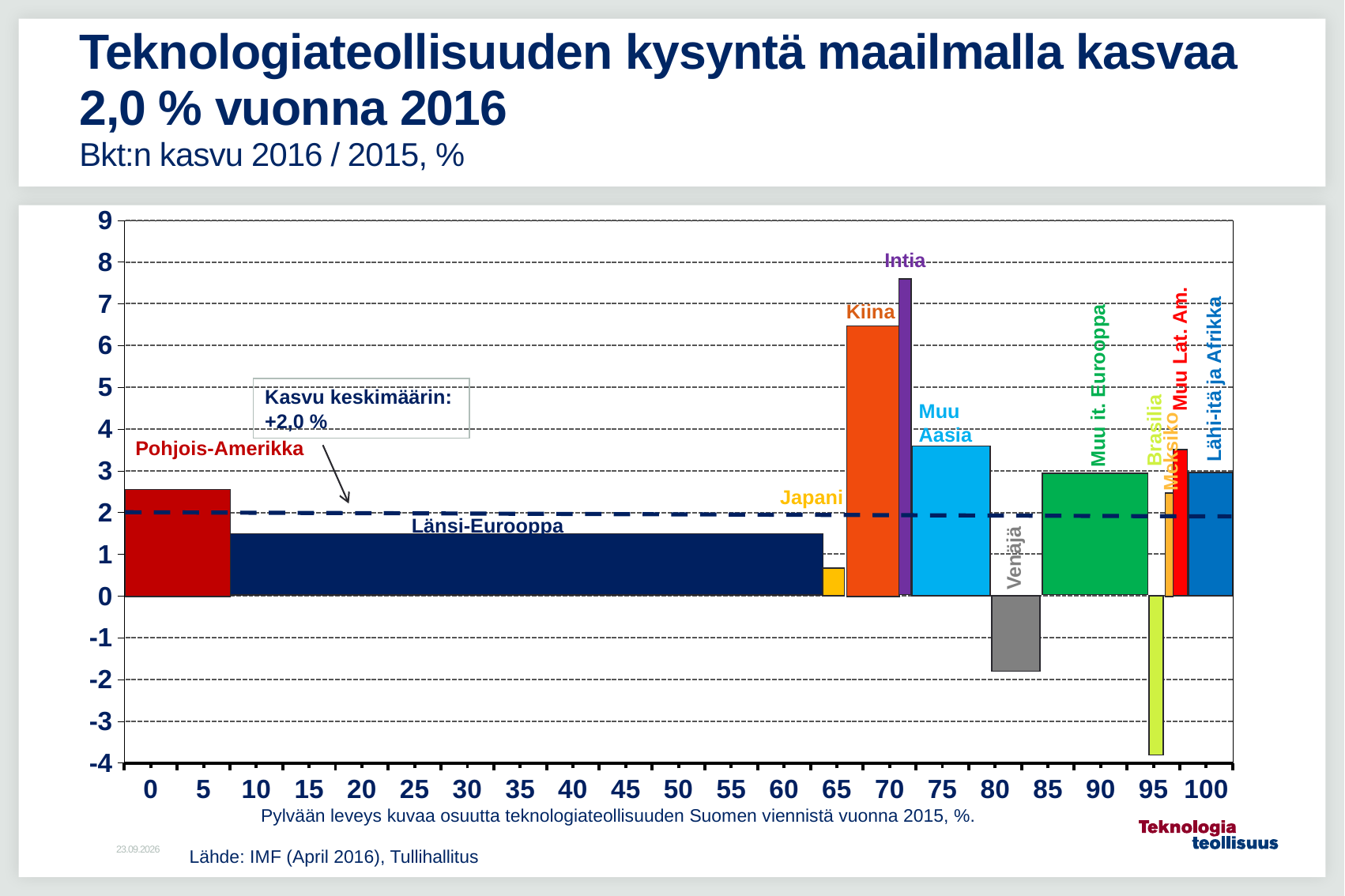
How many regions are shown as bars in the chart? 12 Which region has the highest GDP growth in the chart? Intia What type of chart is shown on the slide? Bar chart Which has the larger GDP growth, Kiina or Muu Aasia? Kiina Is the value for Kiina greater or less than 6? greater Is the value for Länsi-Eurooppa greater or less than 2? less Which has the larger GDP growth, Pohjois-Amerikka or Länsi-Eurooppa? Pohjois-Amerikka Is the value for Japani greater or less than 1? less Which region has the lowest GDP growth in the chart? Brasilia What average growth value is marked by the dashed line in the chart? +2,0 %